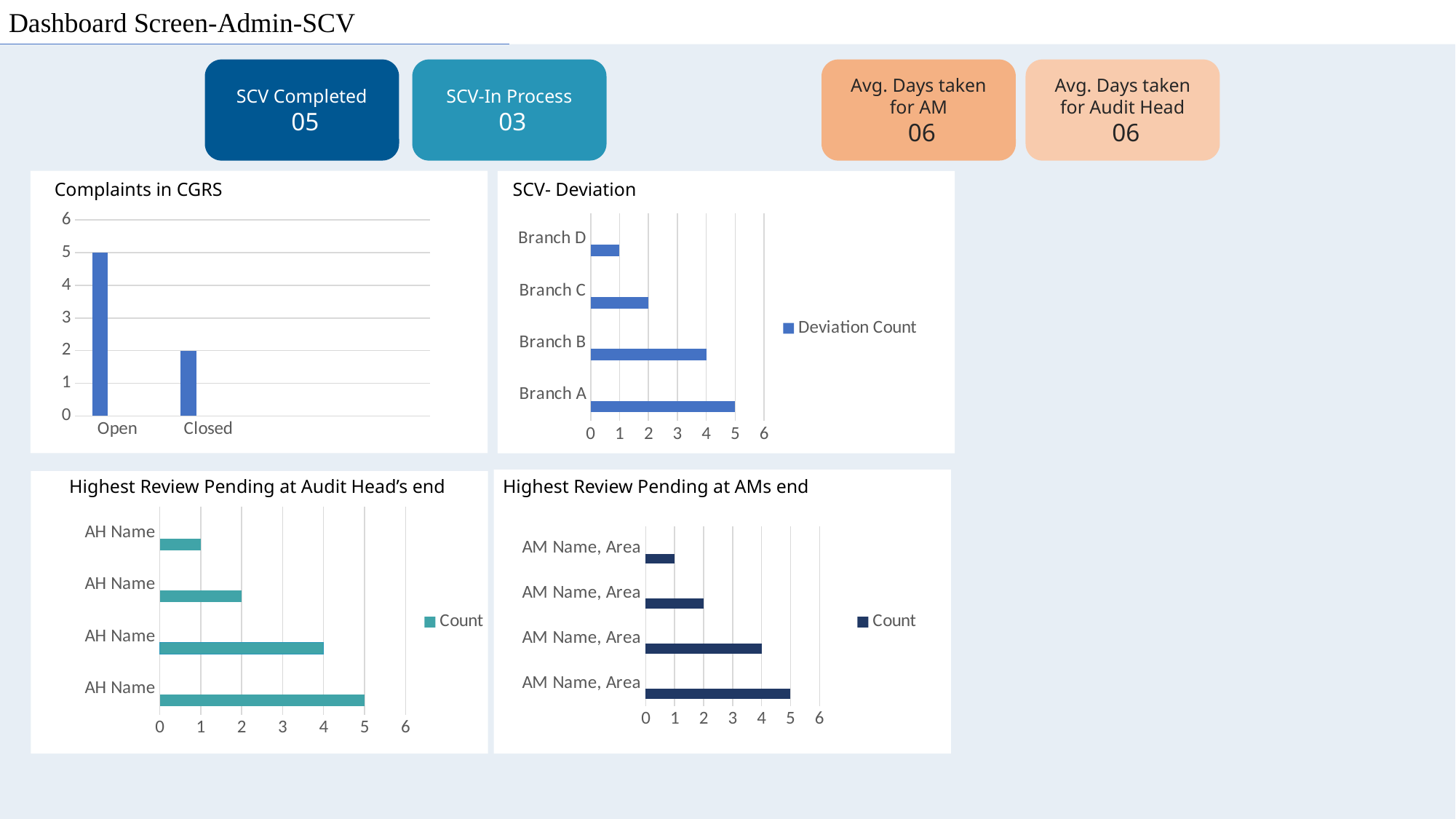
In the SCV- Deviation chart, how many branches are plotted? 4 In the Highest Review Pending at AMs end chart, how many series does the legend list? 1 In the Complaints in CGRS chart, what is the value for Closed? 2 What kind of chart is the Highest Review Pending at Audit Head's end chart? bar chart In the Complaints in CGRS chart, what is the difference between Open and Closed? 3 In the SCV- Deviation chart, which branch has the highest Deviation Count? Branch A In the Complaints in CGRS chart, what is the value for Open? 5 In the SCV- Deviation chart, which is larger, the Deviation Count for Branch B or Branch C? Branch B In the SCV- Deviation chart, what is the Deviation Count for Branch C? 2 In the SCV- Deviation chart, which branch has the lowest Deviation Count? Branch D In the Highest Review Pending at Audit Head's end chart, what is the name of the series in the legend? Count In the SCV- Deviation chart, what is the Deviation Count for Branch A? 5